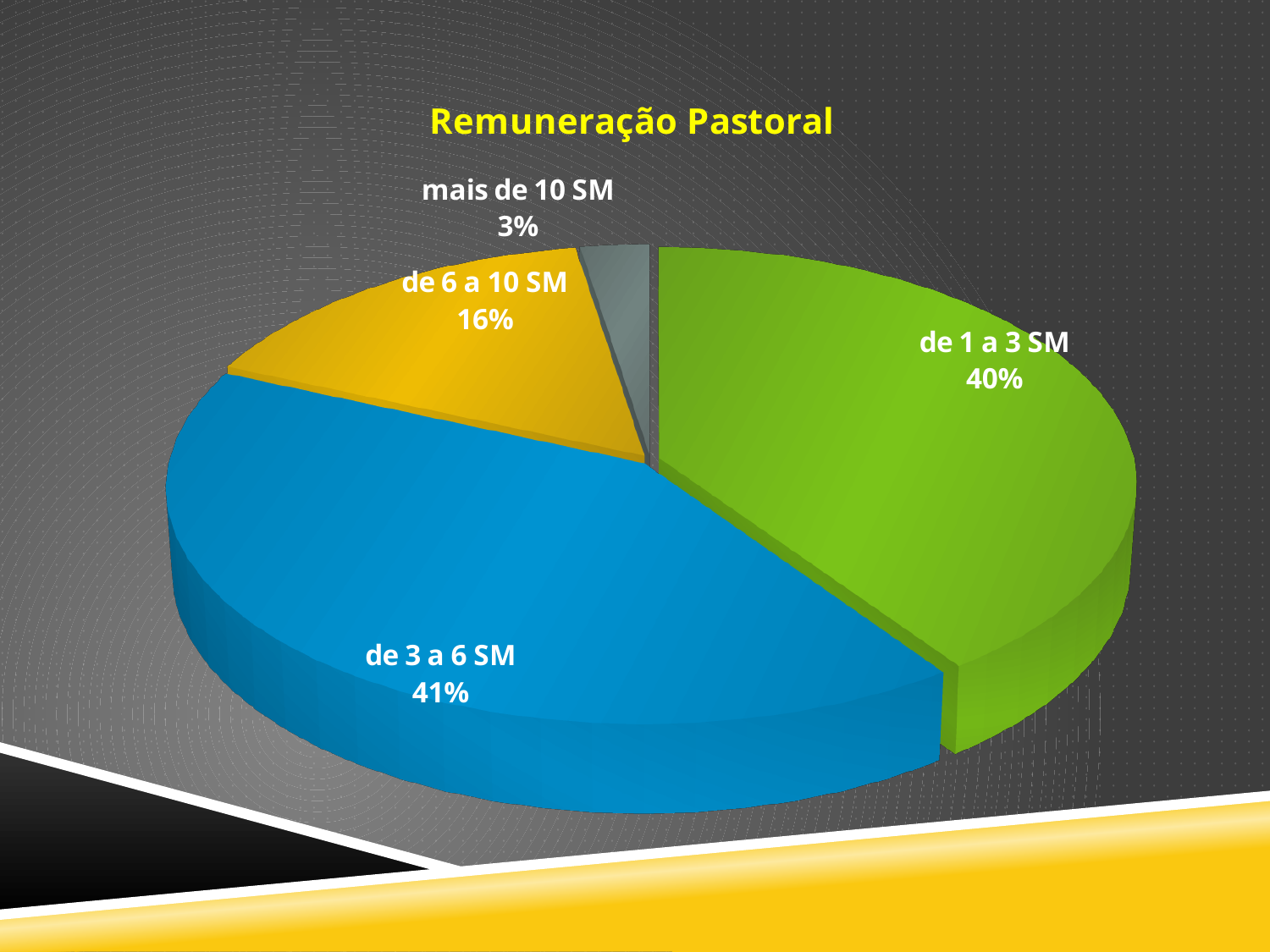
What share of the pie does 'de 3 a 6 SM' represent? 41% What type of chart is shown on the slide? pie chart What share of the pie does 'de 6 a 10 SM' represent? 16% What is the title of the chart? Remuneração Pastoral How many slices does the pie chart have? 4 Which category has the smallest share of the pie? mais de 10 SM What share of the pie does 'de 1 a 3 SM' represent? 40% What share of the pie does 'mais de 10 SM' represent? 3% What is the difference in percentage points between 'de 6 a 10 SM' and 'mais de 10 SM'? 13 What is the combined share of 'de 1 a 3 SM' and 'de 3 a 6 SM'? 81% What colour is the slice for 'de 3 a 6 SM'? blue Which is larger, the share for 'de 6 a 10 SM' or the share for 'mais de 10 SM'? de 6 a 10 SM